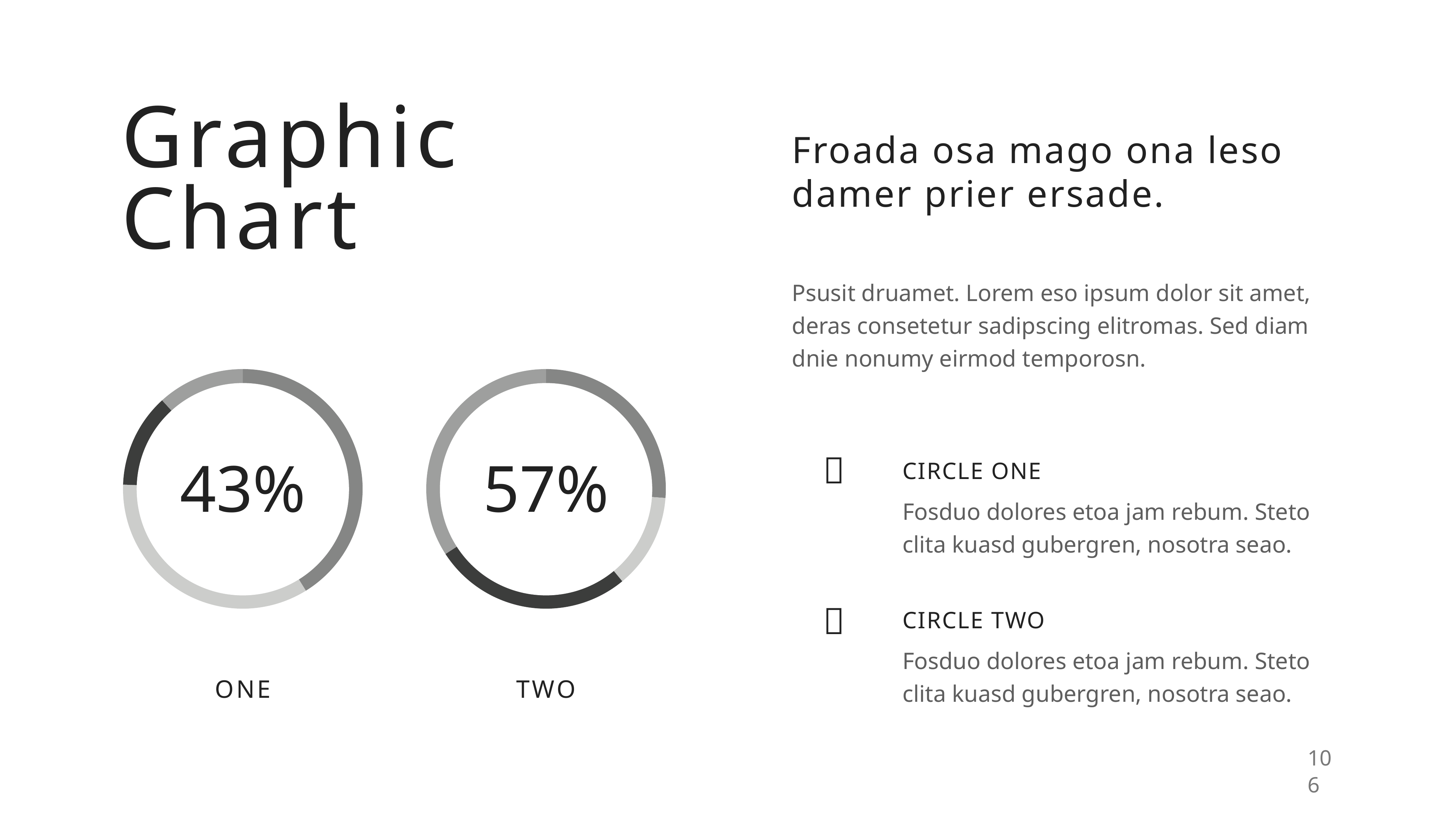
Which chart shows the larger percentage, ONE or TWO? TWO What is the difference in percentage points between the value shown in chart TWO and the value shown in chart ONE? 14 How many doughnut charts are shown on the slide? 2 What is the label printed beneath the left-hand doughnut chart? ONE What kind of chart is the chart labelled ONE? Doughnut chart Is the value shown in the centre of chart TWO greater or less than 50%? greater Is the value shown in the centre of chart ONE greater or less than 50%? less What is the label printed beneath the right-hand doughnut chart? TWO What percentage is shown in the centre of the chart labelled TWO? 57% What percentage is shown in the centre of the chart labelled ONE? 43% Which chart shows the smaller percentage, ONE or TWO? ONE